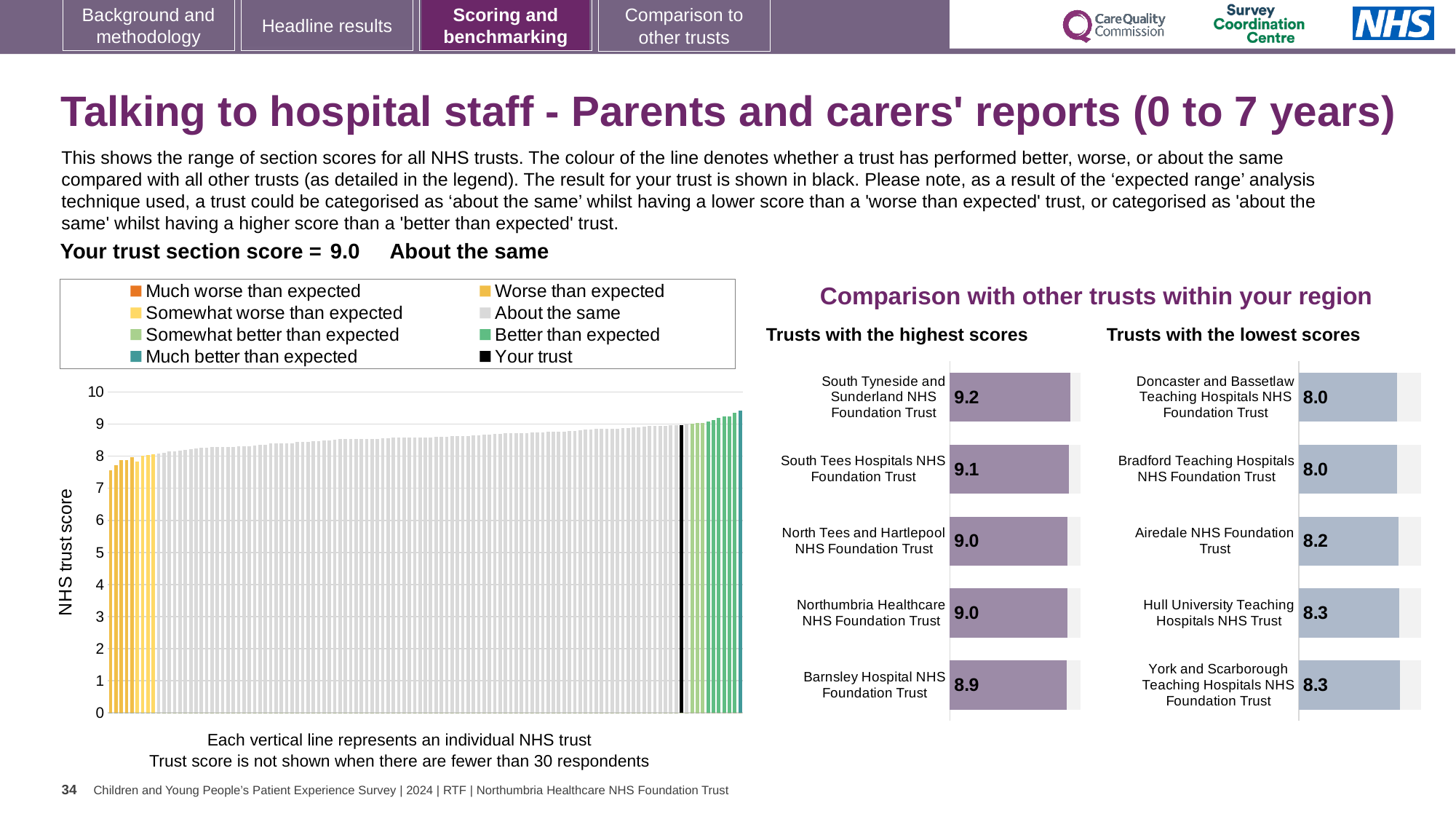
In the 'Trusts with the lowest scores' chart, what is the score for Airedale NHS Foundation Trust? 8.2 How many trusts are shown in the 'Trusts with the highest scores' chart? 5 In the 'Trusts with the highest scores' chart, which trust has the highest score? South Tyneside and Sunderland NHS Foundation Trust In the 'Trusts with the lowest scores' chart, what is the score for York and Scarborough Teaching Hospitals NHS Foundation Trust? 8.3 What kind of chart is the large 'NHS trust score' chart on the left of the slide? Bar chart In the large 'NHS trust score' chart on the left, do the bar heights rise or fall from left to right? Rise How many entries does the legend above the large 'NHS trust score' chart list? 8 In the 'Trusts with the highest scores' chart, what is the difference between the scores of South Tyneside and Sunderland NHS Foundation Trust and Barnsley Hospital NHS Foundation Trust? 0.3 In the 'Trusts with the lowest scores' chart, which has the higher score: Hull University Teaching Hospitals NHS Trust or Airedale NHS Foundation Trust? Hull University Teaching Hospitals NHS Trust In the 'Trusts with the highest scores' chart, which trust has the lowest score? Barnsley Hospital NHS Foundation Trust In the large 'NHS trust score' chart on the left, is the value of the black bar (your trust) greater or less than 8? greater In the 'Trusts with the highest scores' chart, what is the score for South Tyneside and Sunderland NHS Foundation Trust? 9.2